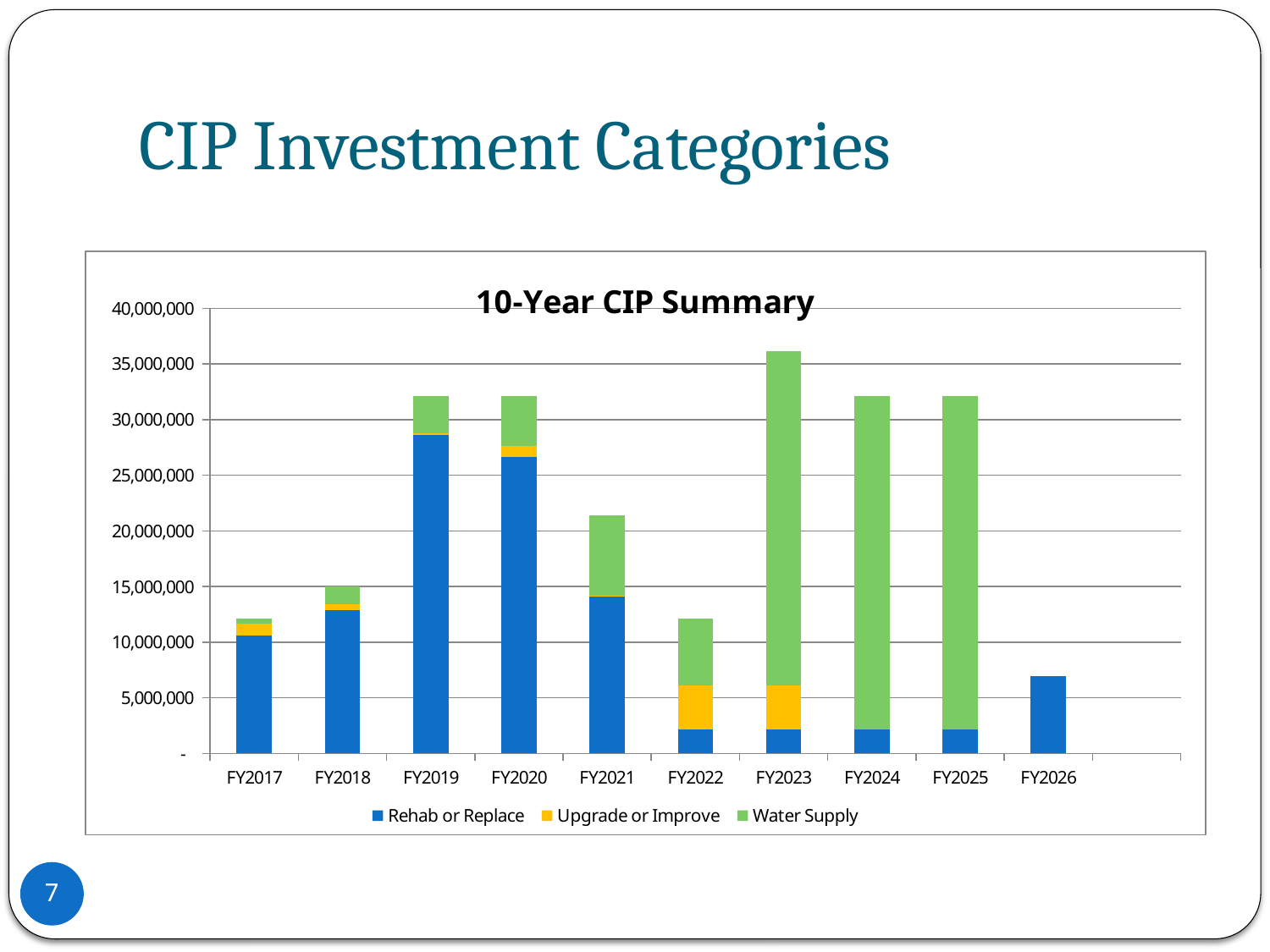
Which fiscal year has the highest total bar? FY2023 What kind of chart is shown on the slide? Stacked bar chart Which colour represents the Water Supply series in the legend? Green Which has the larger total bar, FY2019 or FY2021? FY2019 Is the total bar for FY2026 greater or less than 10,000,000? less Which fiscal year has the lowest total bar? FY2026 Which has the larger Water Supply segment, FY2022 or FY2023? FY2023 How many fiscal years are shown on the x axis? 10 Is the total bar for FY2023 greater or less than 35,000,000? greater Is the Rehab or Replace value for FY2019 greater or less than 25,000,000? greater What is the title of the chart? 10-Year CIP Summary How many series does the legend list? 3